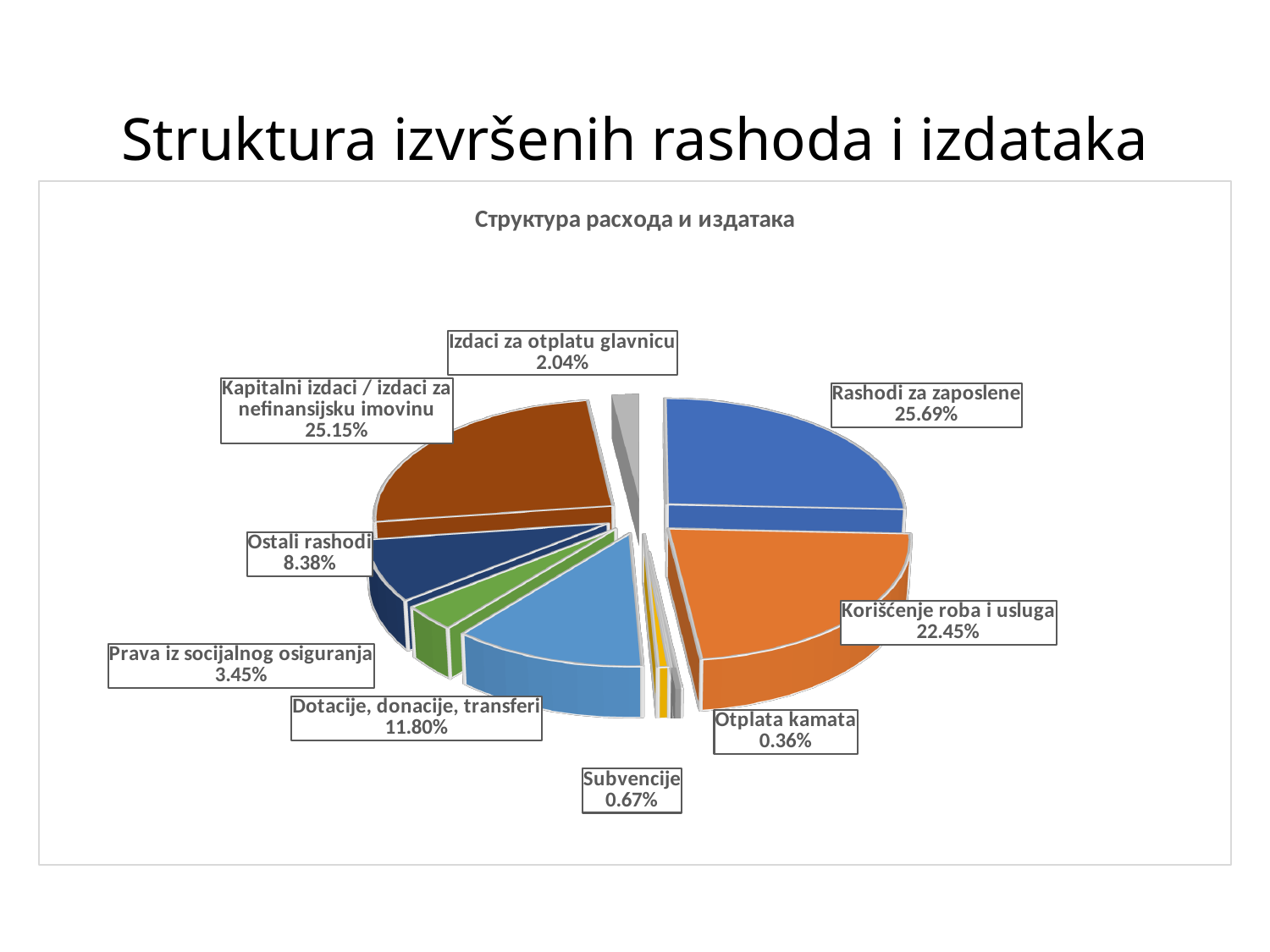
Which is larger, Ostali rashodi or Prava iz socijalnog osiguranja? Ostali rashodi What share of the pie is Rashodi za zaposlene? 25.69% How many slices does the pie chart have? 9 What share of the pie is Dotacije, donacije, transferi? 11.80% Which category has the smallest share of the pie? Otplata kamata What kind of chart is shown on the slide? pie chart What is the chart's title? Структура расхода и издатака Which category has the largest share of the pie? Rashodi za zaposlene What is the difference in percentage points between Rashodi za zaposlene and Korišćenje roba i usluga? 3.24% What share of the pie is Otplata kamata? 0.36%